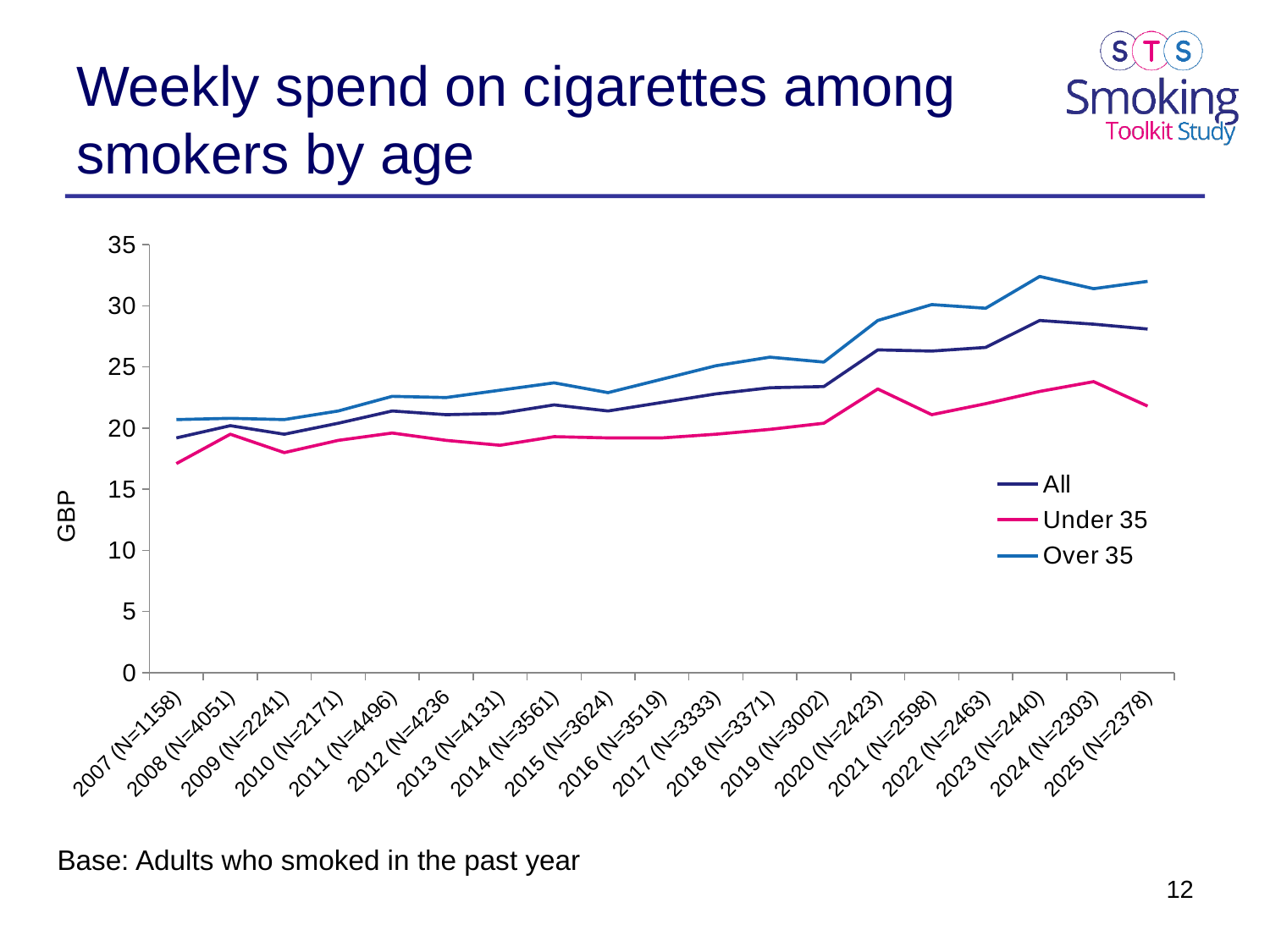
How many series does the legend list? 3 What is the label on the y axis? GBP Is the value for Under 35 in 2007 (N=1158) greater or less than 20? less Is the value for All in 2025 (N=2378) greater or less than 25? greater Which series has the highest value in 2025 (N=2378)? Over 35 Is the value for Over 35 in 2023 (N=2440) greater or less than 30? greater Does the Over 35 series generally rise or fall from 2007 to 2025? Rise How many years are plotted along the x axis? 19 In which year does the Over 35 series reach its highest value? 2023 (N=2440) Which series has the lowest value in 2007 (N=1158)? Under 35 Which is larger in 2023 (N=2440), the value for Over 35 or the value for Under 35? Over 35 What kind of chart is shown on the slide? Line chart